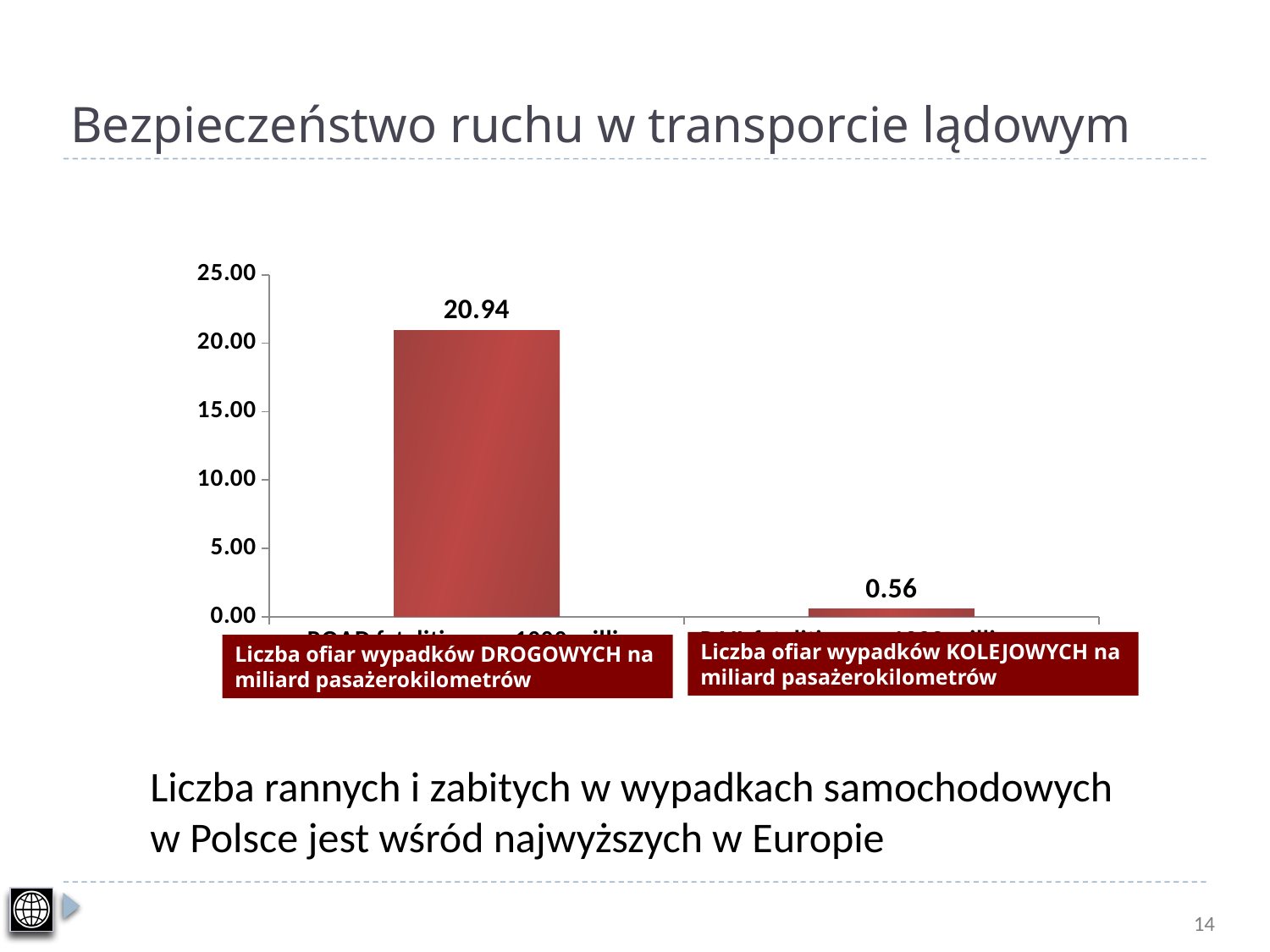
Which category has the higher value, road (DROGOWYCH) or rail (KOLEJOWYCH) accident victims? Road (DROGOWYCH) What is the difference between the road accident victims value and the rail accident victims value? 20.38 Is the value for rail accident victims greater or less than 5.00? less Which category has the lowest value on the chart? Rail (KOLEJOWYCH) accident victims Is the value for road accident victims greater or less than 20.00? greater What type of chart is shown on the slide? Bar chart Is the rail accident victims value larger or smaller than the road accident victims value? Smaller What colour are the bars in the chart? Red What is the value shown for rail accident victims (wypadków KOLEJOWYCH) per billion passenger-kilometres? 0.56 What is the value shown for road accident victims (wypadków DROGOWYCH) per billion passenger-kilometres? 20.94 How many bars are plotted on the chart? 2 What is the maximum value shown on the vertical axis of the chart? 25.00